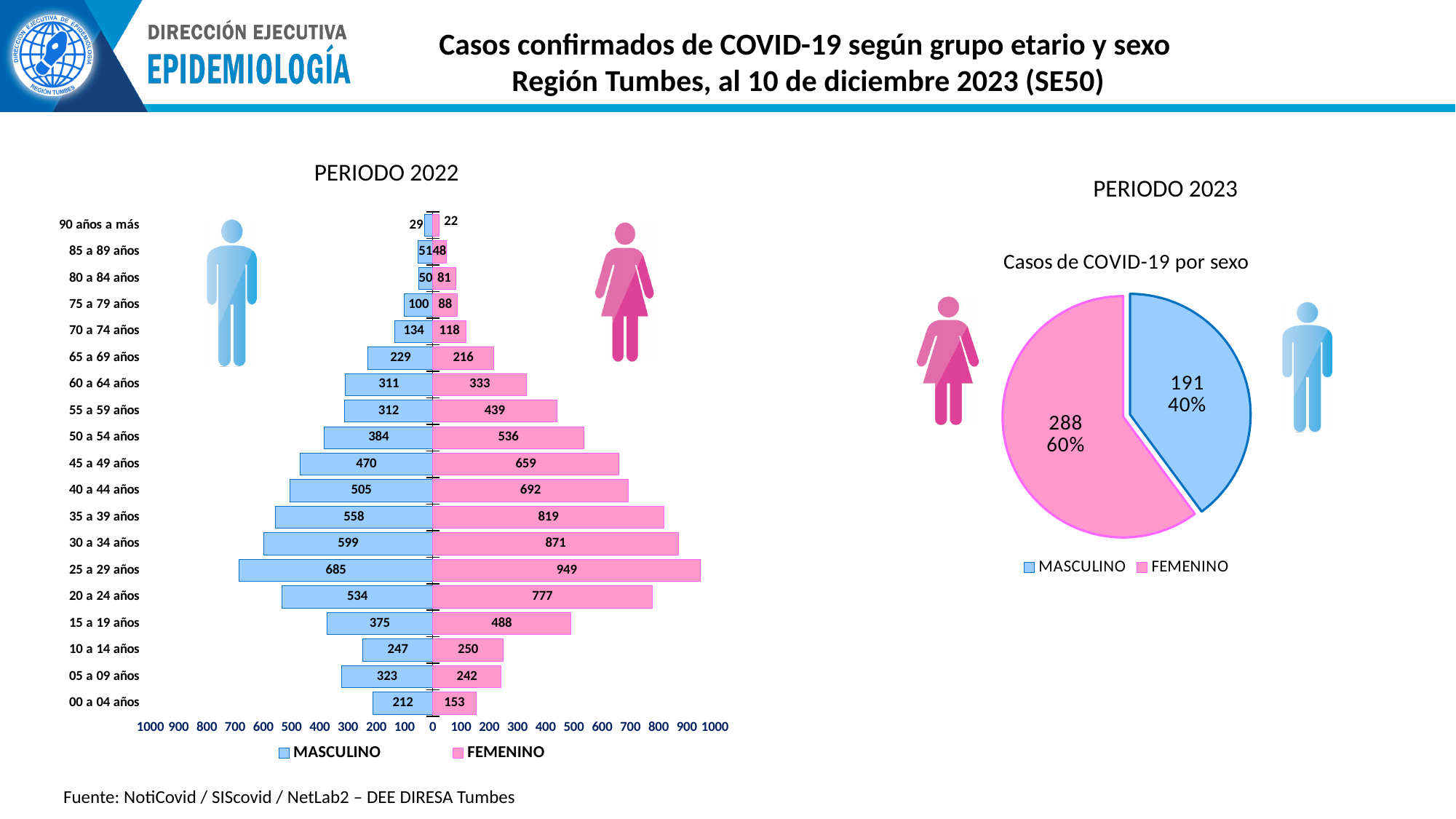
In the PERIODO 2022 chart, which age group has the lowest MASCULINO value? 90 años a más What kind of chart is the PERIODO 2022 chart? Bar chart In the PERIODO 2022 chart, how many MASCULINO cases are shown for the 25 a 29 años group? 685 In the PERIODO 2023 pie chart, how many MASCULINO cases are shown? 191 In the PERIODO 2022 chart, which is larger for the 05 a 09 años group, MASCULINO or FEMENINO? MASCULINO In the PERIODO 2023 pie chart, what share of cases is FEMENINO? 60% In the PERIODO 2022 chart, how many FEMENINO cases are shown for the 30 a 34 años group? 871 What is the title of the PERIODO 2023 pie chart? Casos de COVID-19 por sexo In the PERIODO 2022 chart, what is the difference between the FEMENINO and MASCULINO values for the 20 a 24 años group? 243 In the PERIODO 2022 chart, how many series does the legend list? 2 In the PERIODO 2022 chart, which age group has the highest FEMENINO value? 25 a 29 años In the PERIODO 2022 chart, how many age groups are plotted? 19